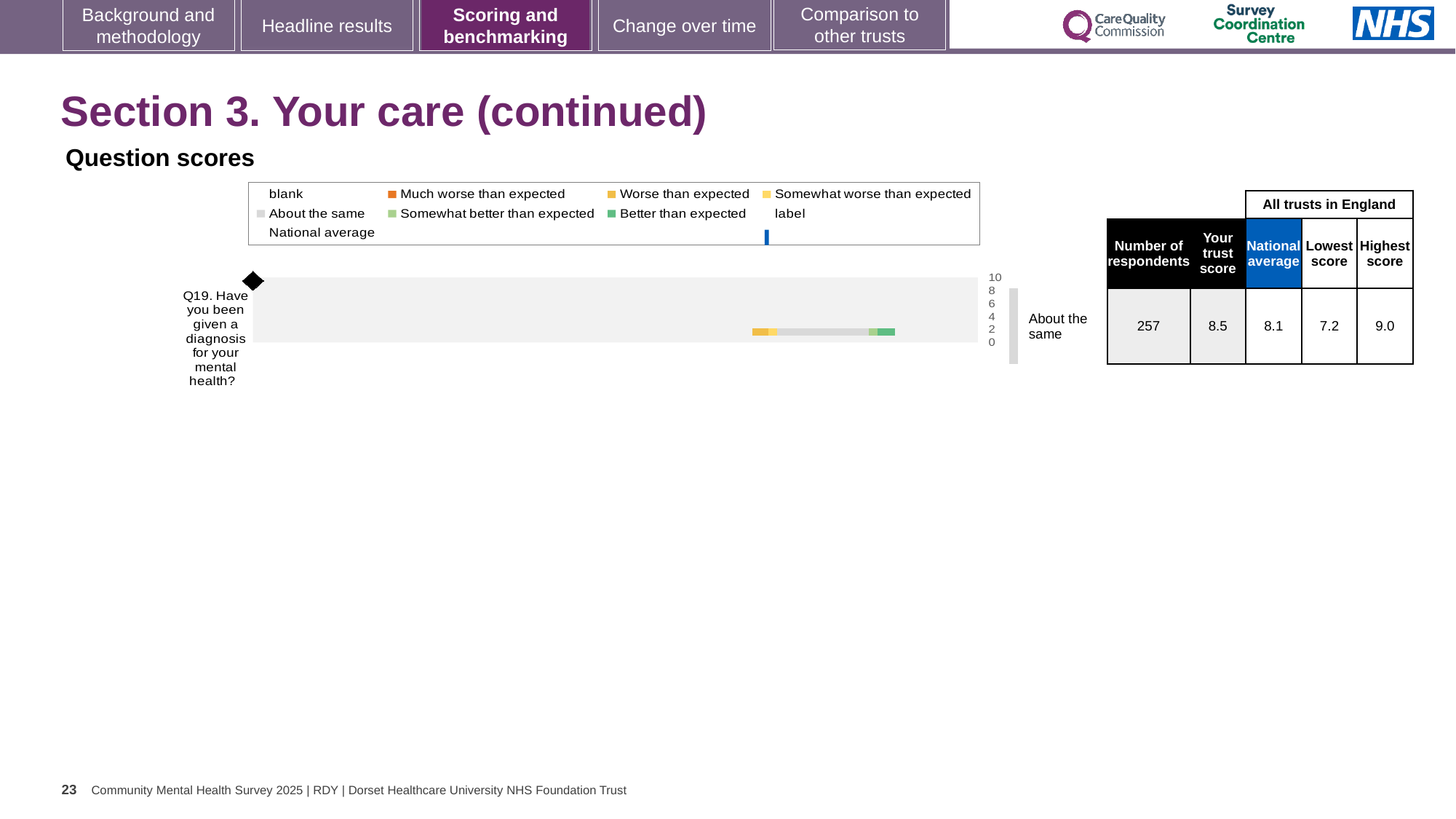
What is the highest score among all trusts in England for Q19? 9.0 What is the trust score for Q19 (Have you been given a diagnosis for your mental health?)? 8.5 What is the national average score for Q19? 8.1 How many questions are plotted on the chart? 1 What colour in the legend represents 'Much worse than expected'? Orange What is the difference between the trust score and the national average for Q19? 0.4 How is the trust's result for Q19 categorised relative to expectations? About the same How many respondents answered Q19? 257 What kind of chart is shown on the slide? Bar chart Which is larger for Q19, the trust score or the national average? Trust score What is the difference between the highest and lowest scores among all trusts in England for Q19? 1.8 What is the lowest score among all trusts in England for Q19? 7.2